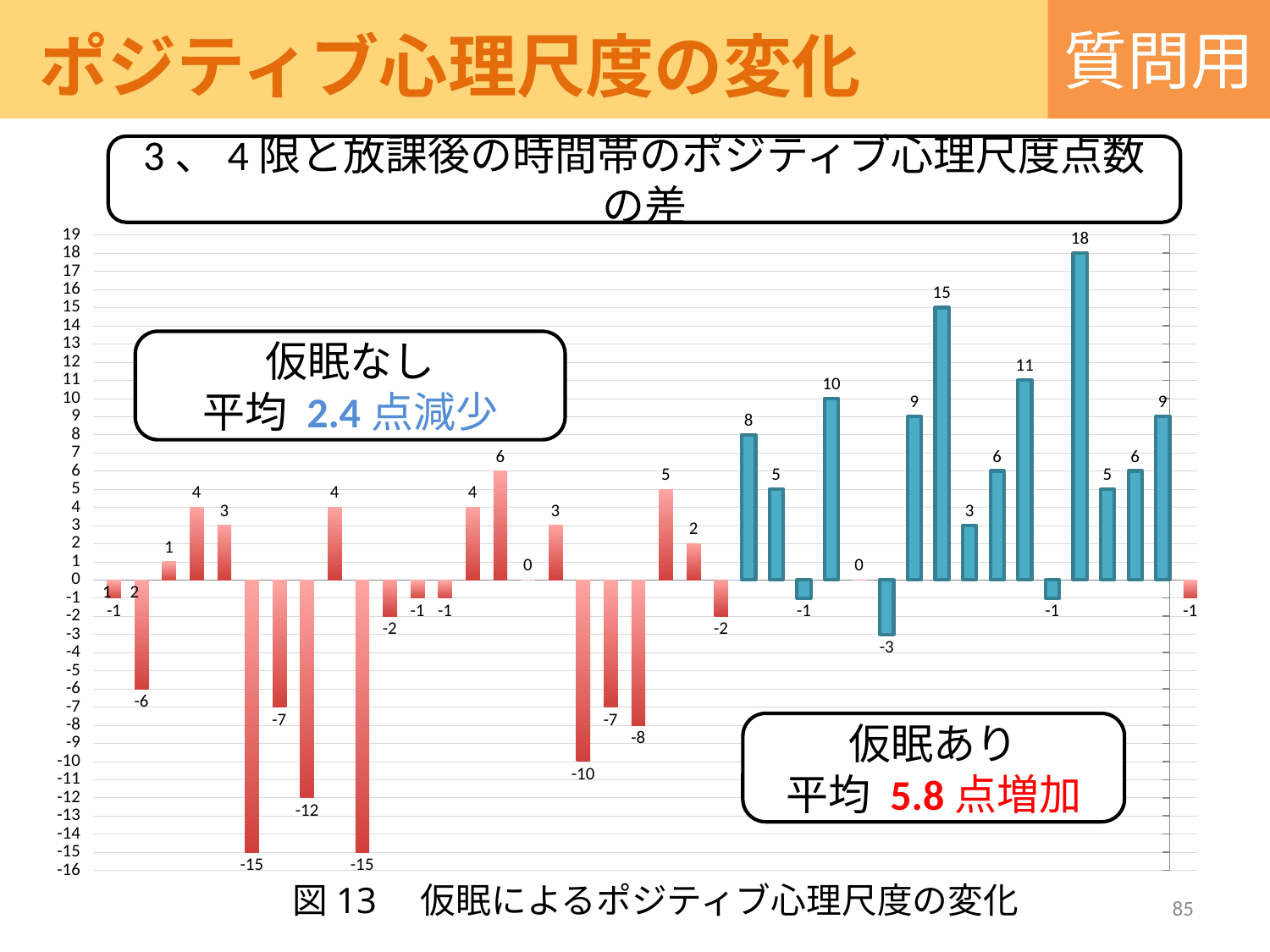
What is the maximum value shown on the vertical axis? 19 Which colour are the bars for the 仮眠あり group? blue What kind of chart is shown on the slide? bar chart Which is larger: the highest blue bar (18) or the highest red bar (6)? the highest blue bar (18) What is the highest value shown by any bar in the chart? 18 What is the lowest value among the blue (仮眠あり) bars? -3 According to the annotation, by how many points did the 仮眠あり group increase on average? 5.8 What is the lowest value shown by any bar in the chart? -15 What is the value of the tallest red (仮眠なし) bar? 6 According to the annotation, by how many points did the 仮眠なし group decrease on average? 2.4 What is the title shown above the chart? 3、4限と放課後の時間帯のポジティブ心理尺度点数の差 What is the difference between the highest bar value (18) and the lowest bar value (-15)? 33